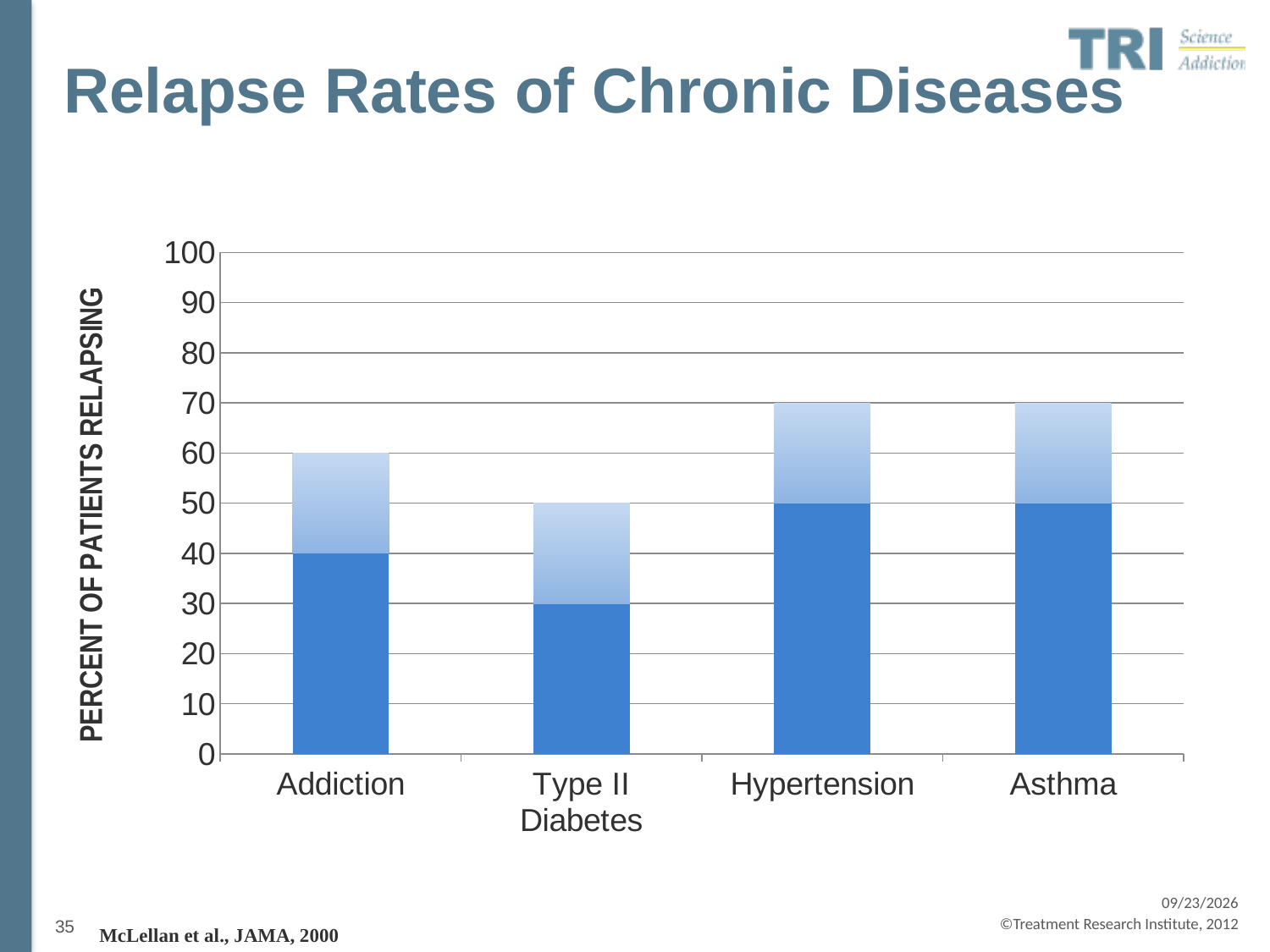
Which disease has the lowest total bar? Type II Diabetes What is the total height of the bar for Hypertension? 70 What value does the darker lower segment of the Type II Diabetes bar reach? 30 What is the total height of the bar for Type II Diabetes? 50 Which bar is taller, Addiction or Type II Diabetes? Addiction What kind of chart is shown on the slide? Bar chart What is the label on the vertical axis of the chart? PERCENT OF PATIENTS RELAPSING Is the total bar for Asthma greater or less than 60? greater What is the total height of the bar for Addiction? 60 How many diseases are shown on the x axis of the chart? 4 What is the difference between the total bar heights for Hypertension and Type II Diabetes? 20 What value does the darker lower segment of the Addiction bar reach? 40